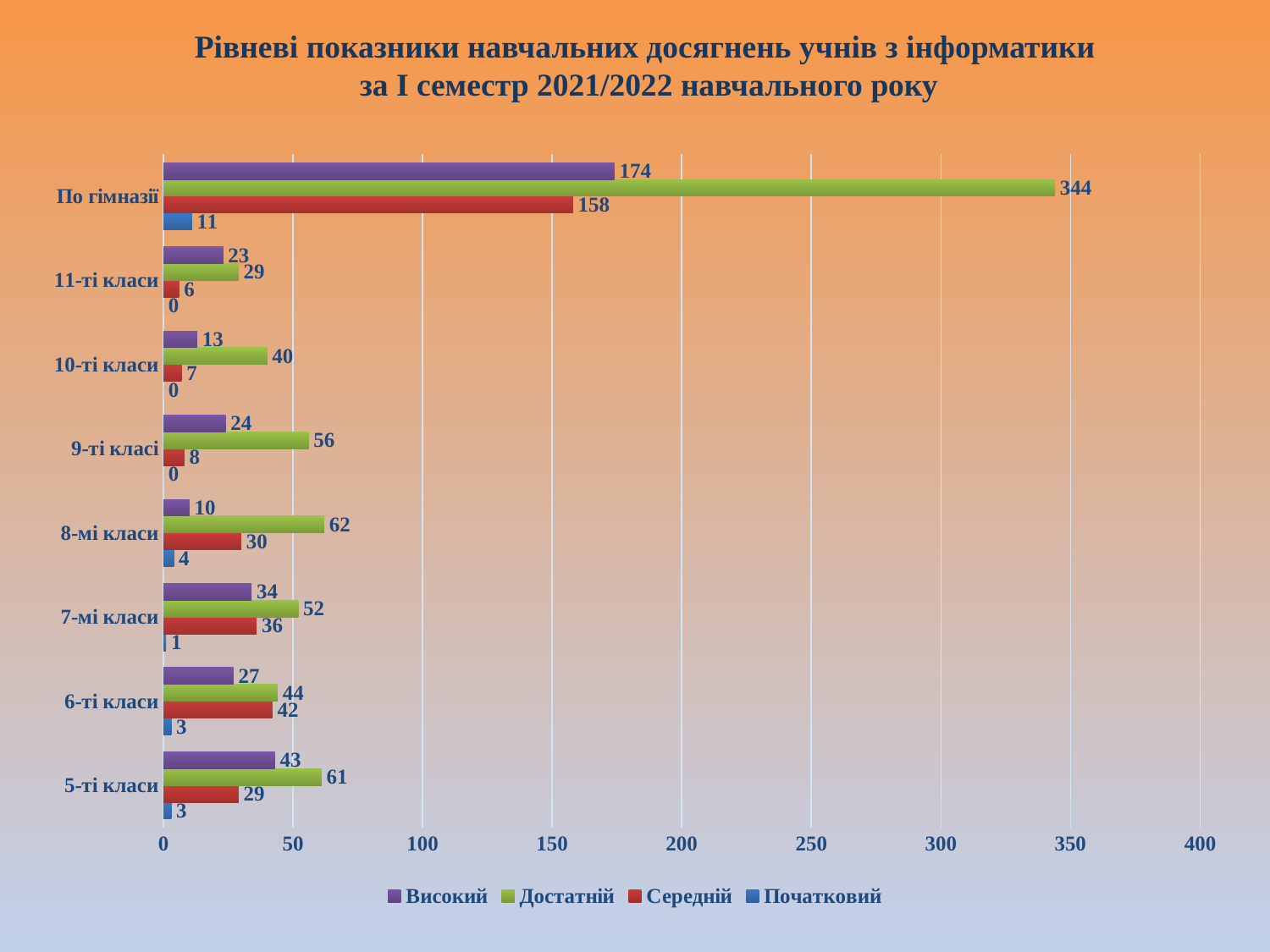
Which category has the highest value for Високий? По гімназії What is the value of Початковий for 8-мі класи? 4 Among the class categories (excluding По гімназії), which has the lowest value for Достатній? 11-ті класи How many categories are shown on the vertical axis? 8 Which is larger for 6-ті класи: Достатній or Середній? Достатній Which series is shown in green in the legend? Достатній What is the difference between the Достатній and Високий values for 5-ті класи? 18 What is the value of Достатній for По гімназії? 344 How many series does the legend list? 4 What is the value of Середній for 7-мі класи? 36 Is the value of Середній for По гімназії greater or less than 150? greater What type of chart is shown on the slide? bar chart